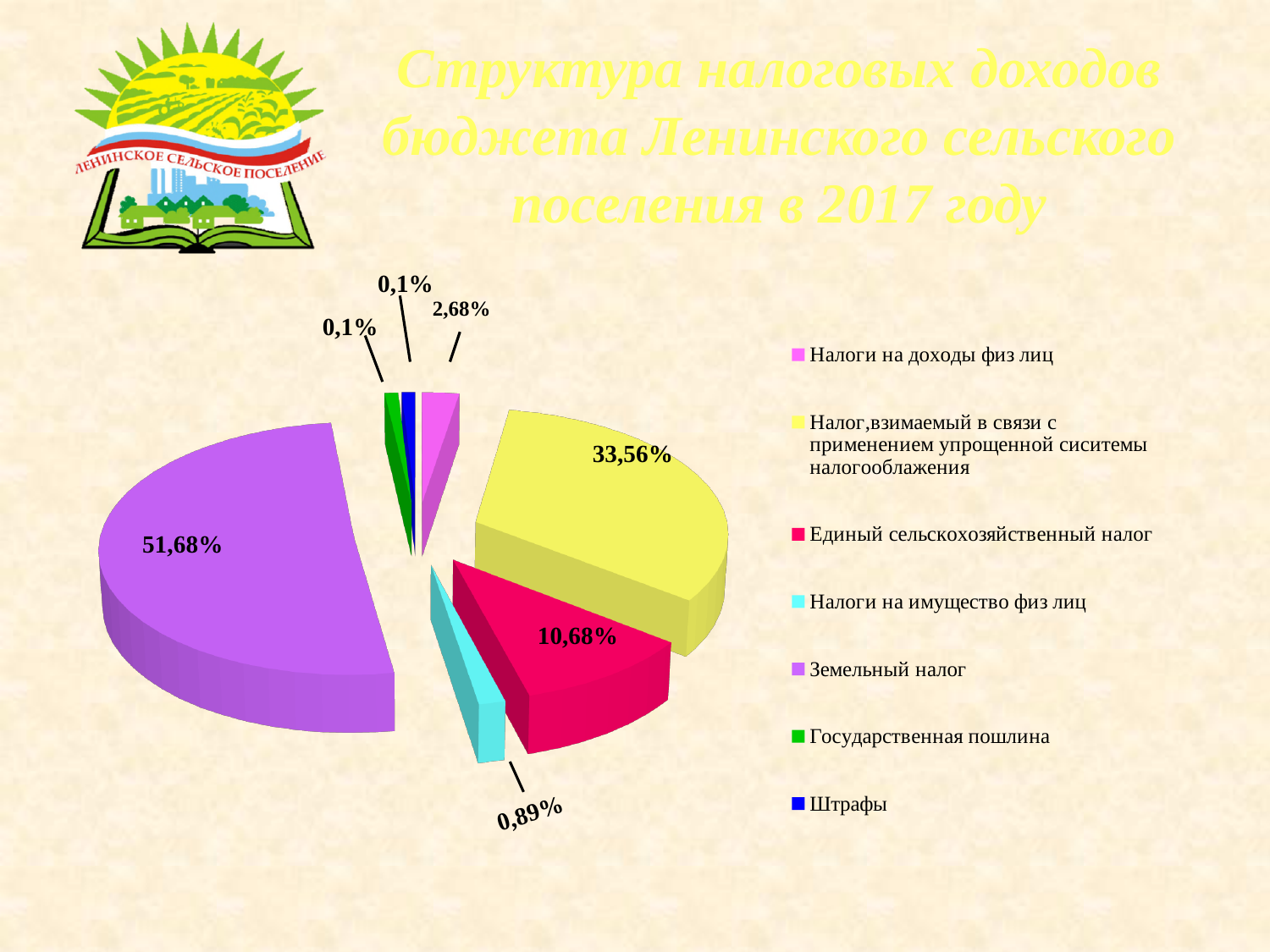
What is the value shown for Налоги на доходы физ лиц? 2,68% Which category has the largest share of the pie? Земельный налог How many categories does the legend list? 7 What is the value shown for Единый сельскохозяйственный налог? 10,68% What is the value shown for Государственная пошлина? 0,1% What kind of chart is shown on the slide? Pie chart What colour is the slice for Штрафы? Blue What is the difference between the shares of Земельный налог and Налог, взимаемый в связи с применением упрощенной системы налогообложения? 18,12% What is the value shown for Налог, взимаемый в связи с применением упрощенной системы налогообложения? 33,56% What share of the pie does Земельный налог account for? 51,68% What is the value shown for Налоги на имущество физ лиц? 0,89% Which is larger: the share of Единый сельскохозяйственный налог or the share of Налоги на доходы физ лиц? Единый сельскохозяйственный налог